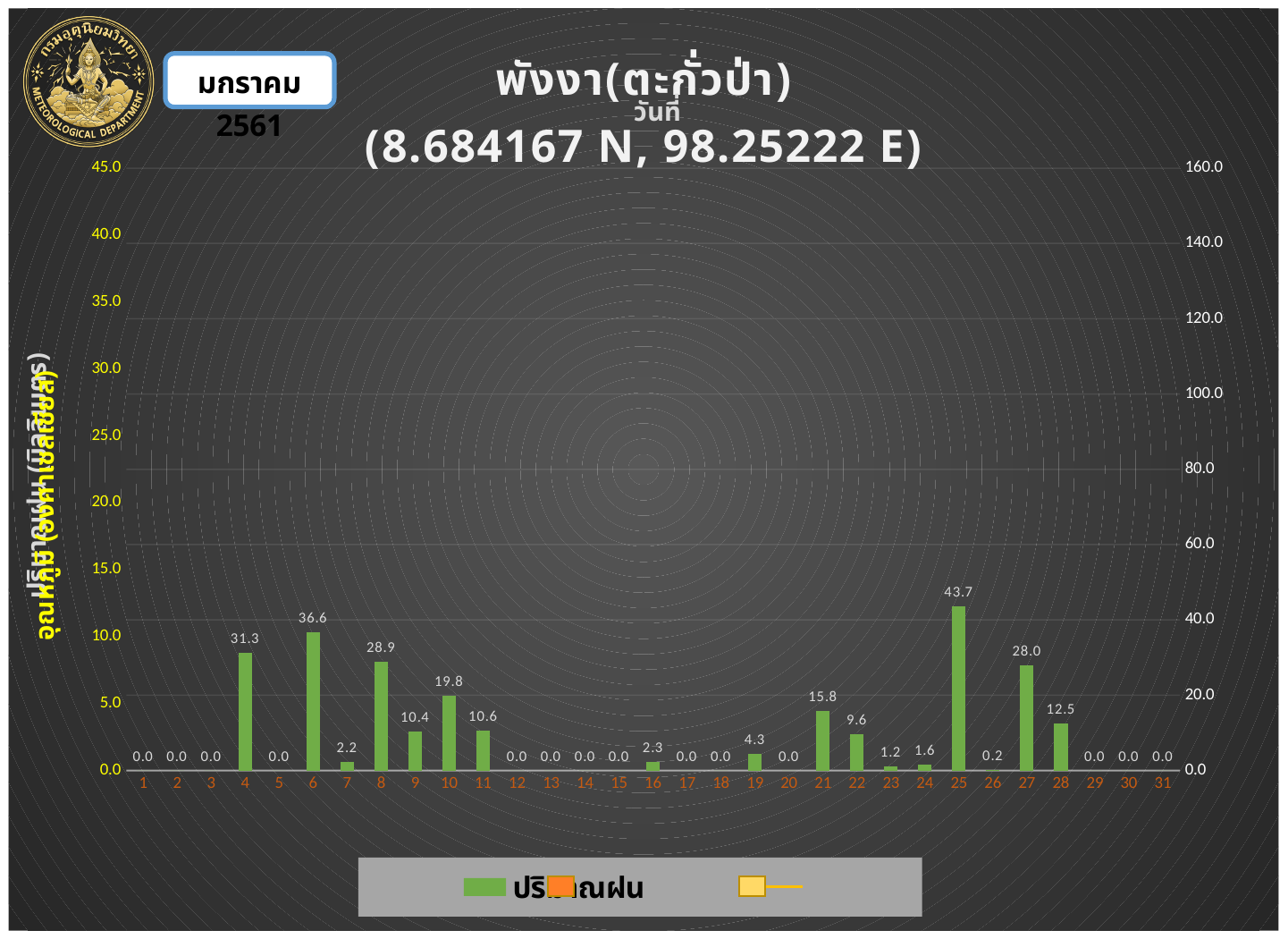
What is the value for day 25? 43.7 What is the value for day 26? 0.2 What kind of chart is this? bar chart What is the value for day 6? 36.6 What is the difference between the values for day 4 and day 8? 2.4 Which is larger, the value for day 27 or the value for day 4? day 4 How many days are shown on the x axis? 31 What are the coordinates shown in the chart title? 8.684167 N, 98.25222 E Which is larger, the value for day 10 or the value for day 28? day 10 What is the value for day 21? 15.8 What is the difference between the values for day 25 and day 6? 7.1 Which day has the highest value? 25